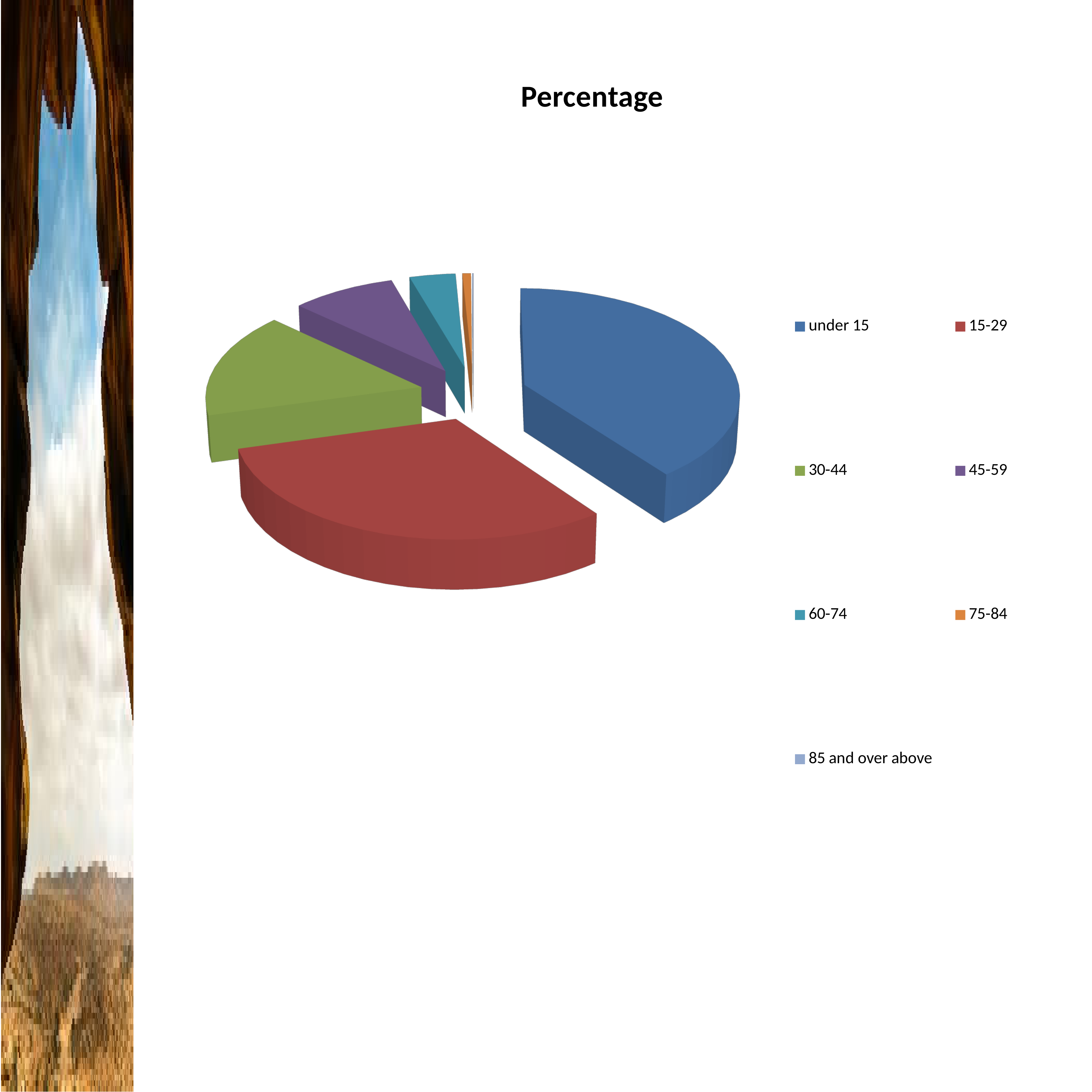
Which category has the largest slice of the pie? under 15 Which slice is larger, 75-84 or 15-29? 15-29 Which slice is larger, 45-59 or 60-74? 45-59 Which slice is larger, 60-74 or under 15? under 15 What kind of chart is shown on the slide? pie chart What is the title of the chart? Percentage What colour is the slice for the 'under 15' category? blue How many categories does the legend of the pie chart list? 7